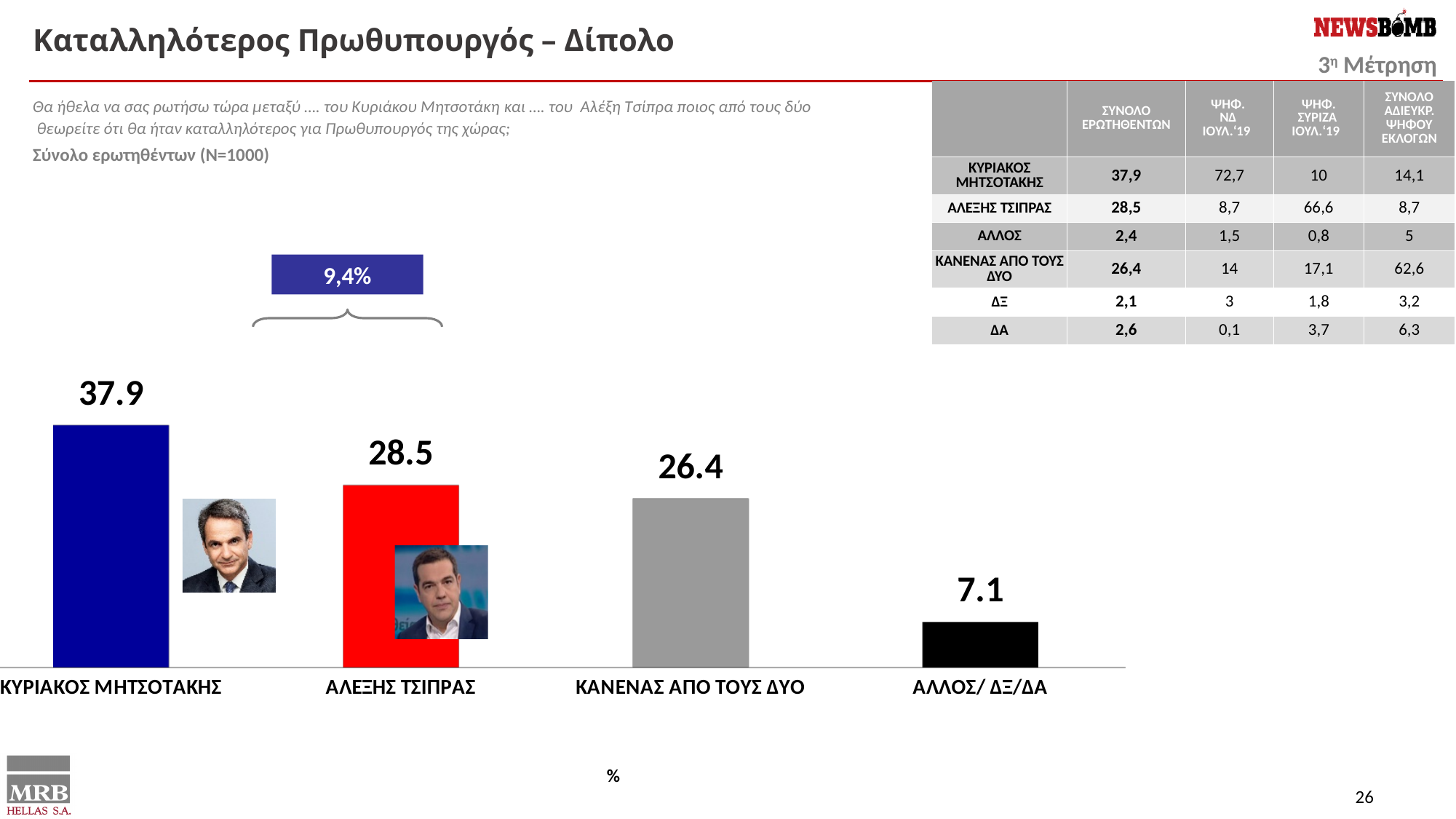
Which is larger in the bar chart, the value for ΑΛΕΞΗΣ ΤΣΙΠΡΑΣ or the value for ΚΑΝΕΝΑΣ ΑΠΟ ΤΟΥΣ ΔΥΟ? ΑΛΕΞΗΣ ΤΣΙΠΡΑΣ What colour is the bar for ΑΛΕΞΗΣ ΤΣΙΠΡΑΣ? red What kind of chart is shown on the slide? bar chart What value is shown for ΑΛΛΟΣ/ ΔΞ/ΔΑ in the bar chart? 7.1 What value is shown for ΚΥΡΙΑΚΟΣ ΜΗΤΣΟΤΑΚΗΣ in the bar chart? 37.9 Which category has the highest value in the bar chart? ΚΥΡΙΑΚΟΣ ΜΗΤΣΟΤΑΚΗΣ What percentage is shown in the blue callout box above the first two bars? 9,4% What value is shown for ΑΛΕΞΗΣ ΤΣΙΠΡΑΣ in the bar chart? 28.5 What value is shown for ΚΑΝΕΝΑΣ ΑΠΟ ΤΟΥΣ ΔΥΟ in the bar chart? 26.4 What is the difference between the values for ΚΥΡΙΑΚΟΣ ΜΗΤΣΟΤΑΚΗΣ and ΑΛΕΞΗΣ ΤΣΙΠΡΑΣ in the bar chart? 9.4 How many categories are shown in the bar chart? 4 Which category has the lowest value in the bar chart? ΑΛΛΟΣ/ ΔΞ/ΔΑ